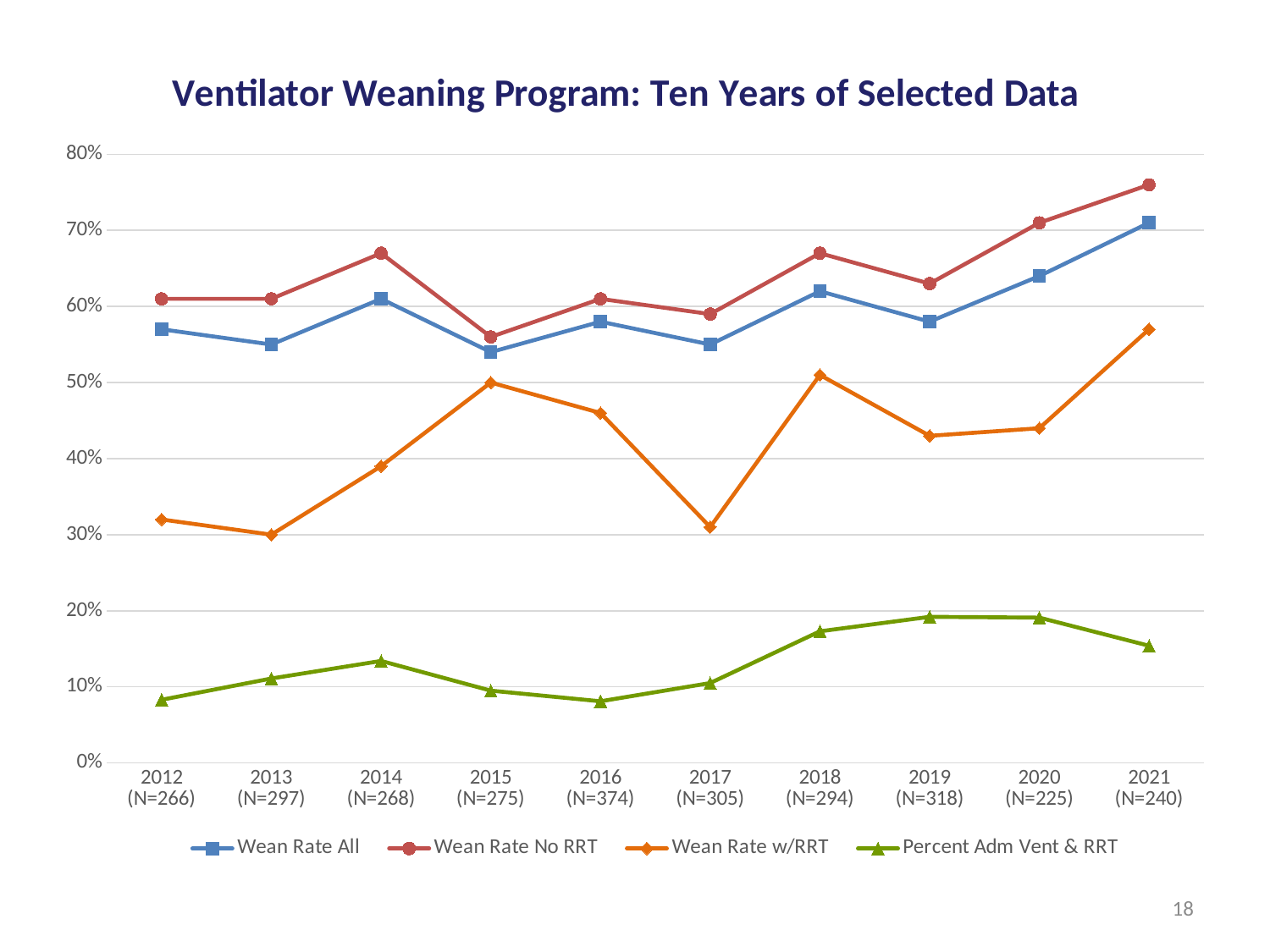
Is the value for Wean Rate w/RRT in 2017 greater or less than 40%? less In which year is the Wean Rate All series at its lowest? 2015 (N=275) What kind of chart is shown on the slide? line chart How many years are plotted along the x axis? 10 Is the value for Wean Rate No RRT in 2021 greater or less than 70%? greater In which year is the Wean Rate w/RRT series at its lowest? 2013 (N=297) What is the title of the chart? Ventilator Weaning Program: Ten Years of Selected Data Does the Wean Rate No RRT series rise or fall from 2019 to 2021? rise In which year is the Wean Rate No RRT series at its highest? 2021 (N=240) Is the value for Percent Adm Vent & RRT in 2019 greater or less than 10%? greater Which is larger in 2018: Wean Rate No RRT or Wean Rate w/RRT? Wean Rate No RRT How many series does the legend list? 4